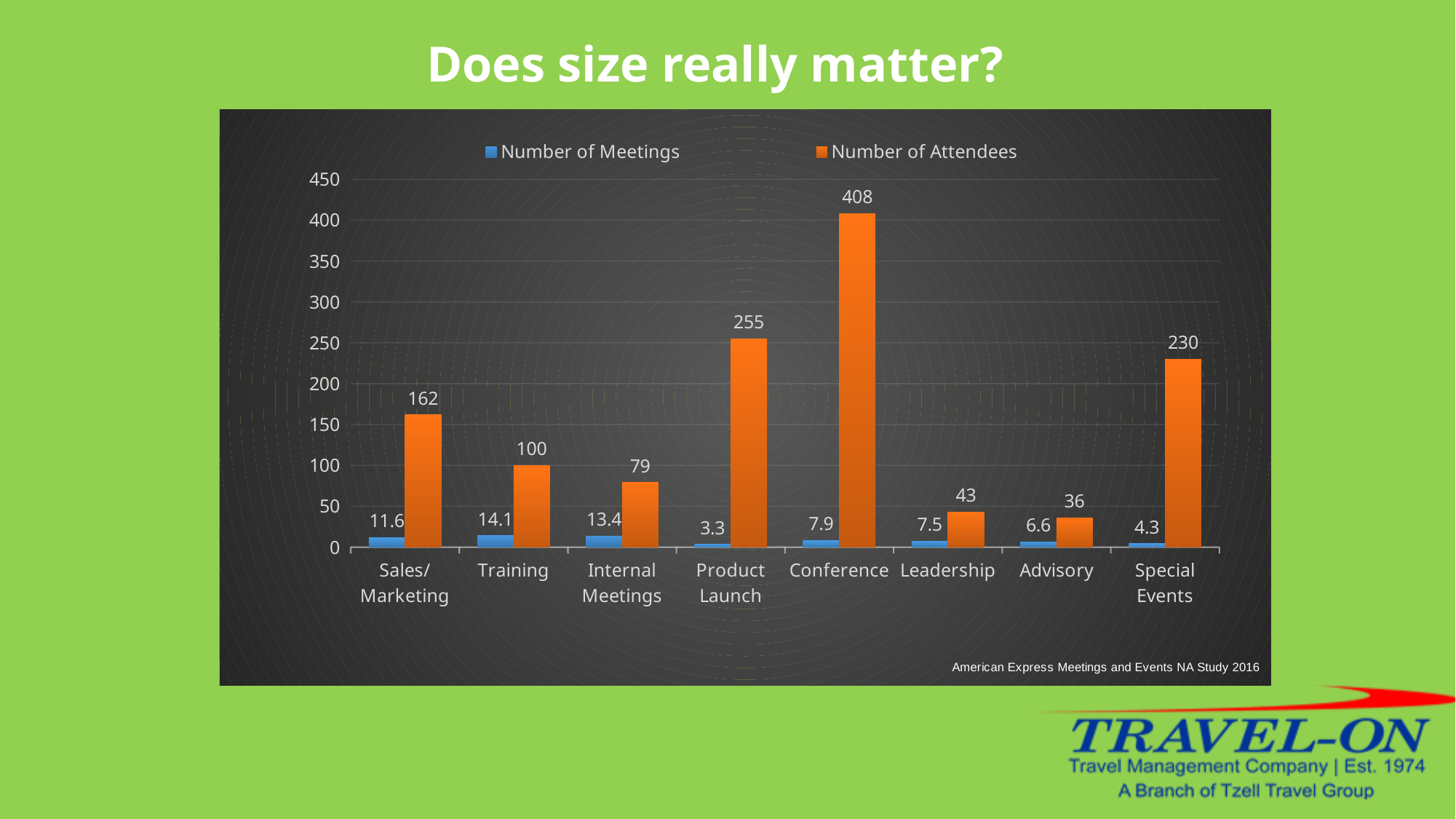
What is the difference in Number of Attendees between Product Launch and Special Events? 25 What is the title of the slide? Does size really matter? What kind of chart is shown on the slide? Bar chart What is the Number of Attendees for Special Events? 230 Which category has the lowest Number of Meetings? Product Launch Which category has the highest Number of Attendees? Conference What is the difference in Number of Meetings between Training and Internal Meetings? 0.7 How many categories are shown on the x axis? 8 Which has a larger Number of Attendees, Sales/Marketing or Training? Sales/Marketing What is the Number of Meetings for Training? 14.1 How many series does the legend list? 2 What is the Number of Attendees for Conference? 408